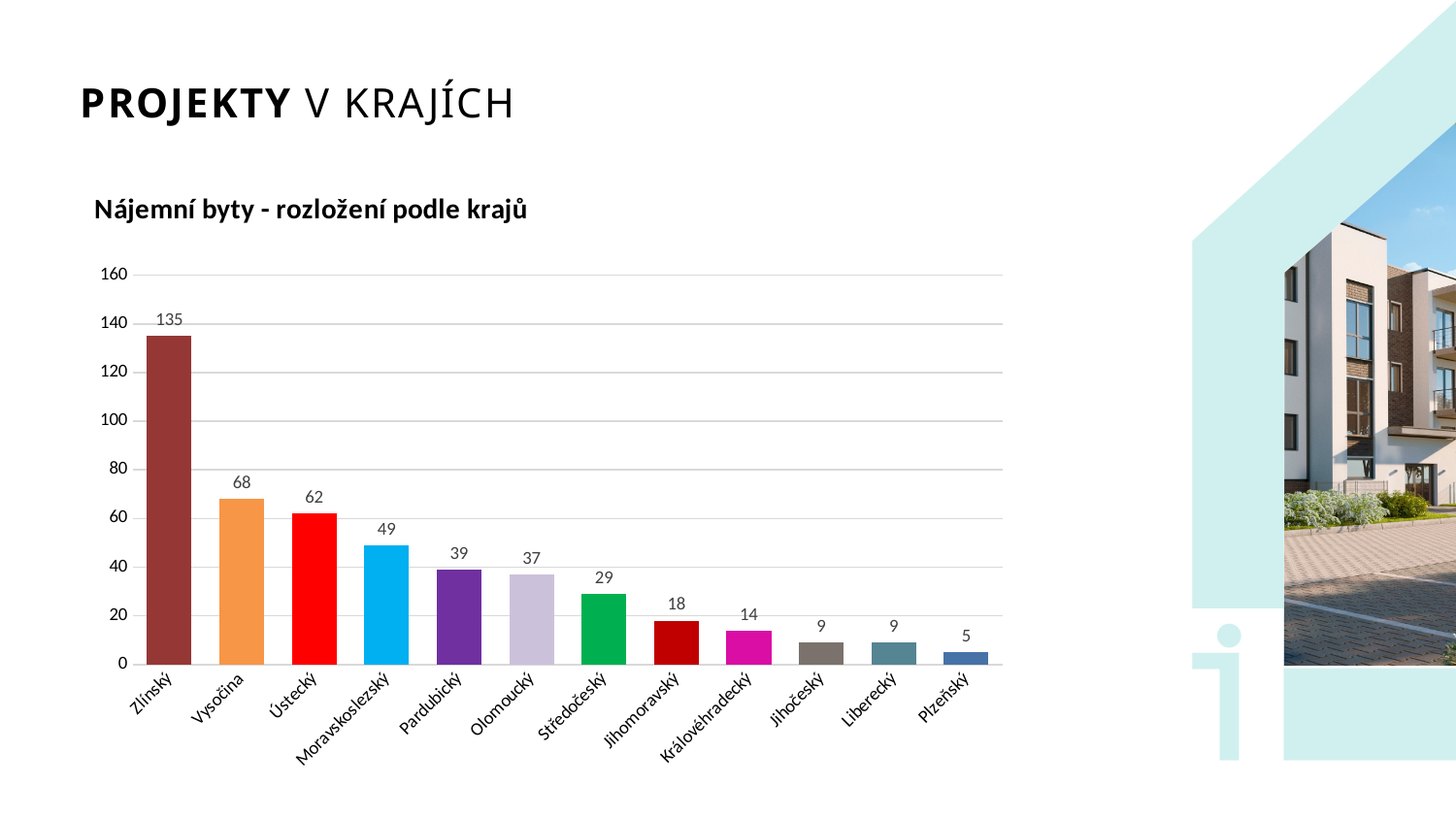
What is the value for Zlínský? 135 What is the title of the chart? Nájemní byty - rozložení podle krajů What kind of chart is shown on the slide? bar chart What is the difference between the values for Vysočina and Ústecký? 6 How many regions are shown on the chart? 12 Which region has the highest value? Zlínský Which region has the lowest value? Plzeňský What is the difference between the values for Zlínský and Středočeský? 106 What is the value for Moravskoslezský? 49 Is the value for Vysočina greater or less than 60? greater Which is larger, the value for Pardubický or the value for Olomoucký? Pardubický What is the value for Královéhradecký? 14